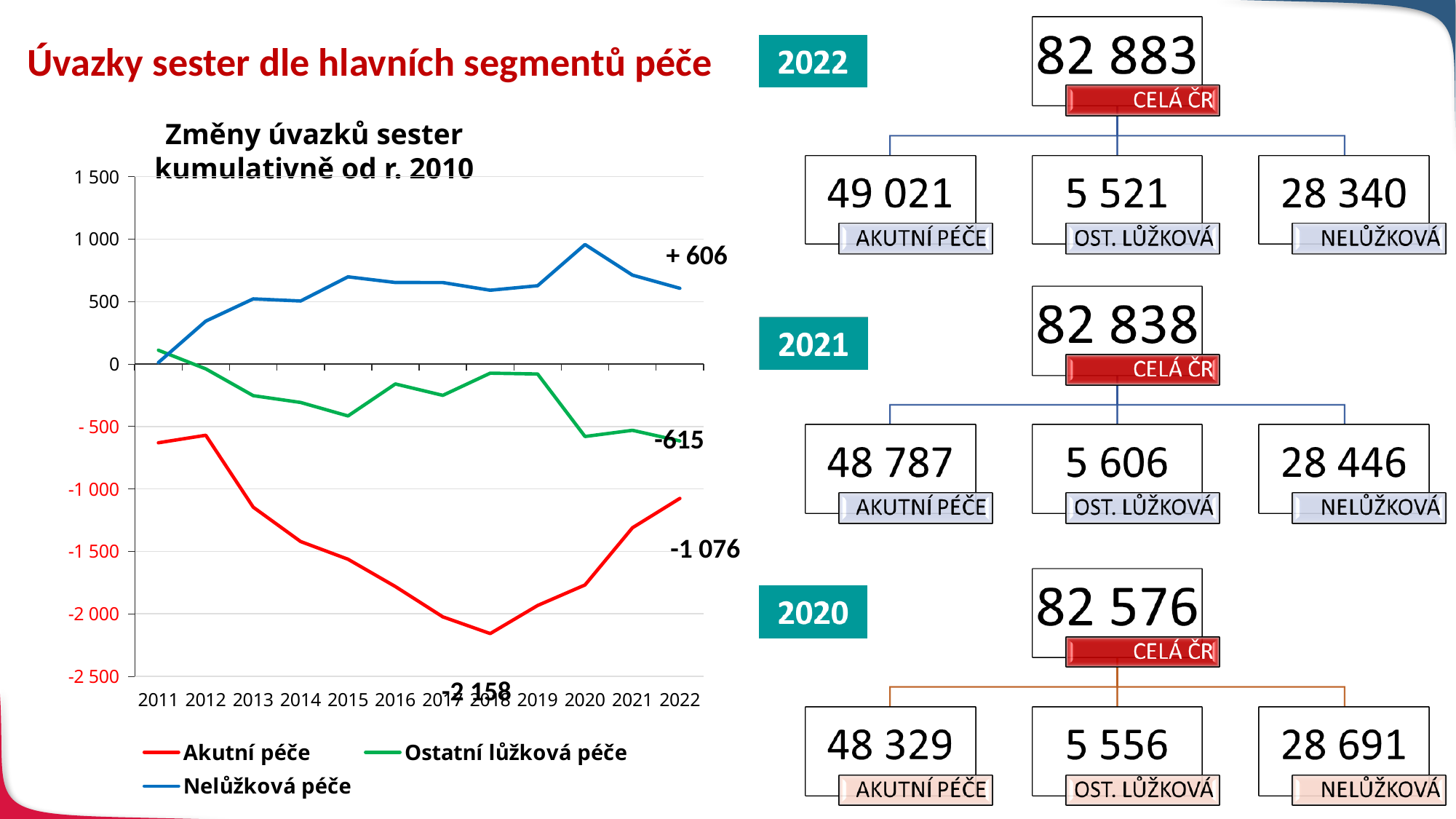
In the line chart, is the value for Nelůžková péče in 2020 greater or less than 500? greater In the line chart, what is the labelled value for Ostatní lůžková péče in 2022? -615 In the line chart, which series has the highest value in 2022? Nelůžková péče In the line chart, what is the labelled value for Akutní péče in 2022? -1 076 What kind of chart is 'Změny úvazků sester kumulativně od r. 2010'? line chart In the line chart, is the value for Akutní péče in 2015 greater or less than -1 000? less In the line chart, what is the labelled lowest value of Akutní péče? -2 158 How many years are shown on the x axis of the line chart? 12 In the line chart, what is the labelled value for Nelůžková péče in 2022? + 606 In the line chart, what is the difference between the 2022 values of Nelůžková péče and Ostatní lůžková péče? 1 221 In the line chart, in which year does Akutní péče reach its lowest value? 2018 How many series does the legend of the line chart list? 3